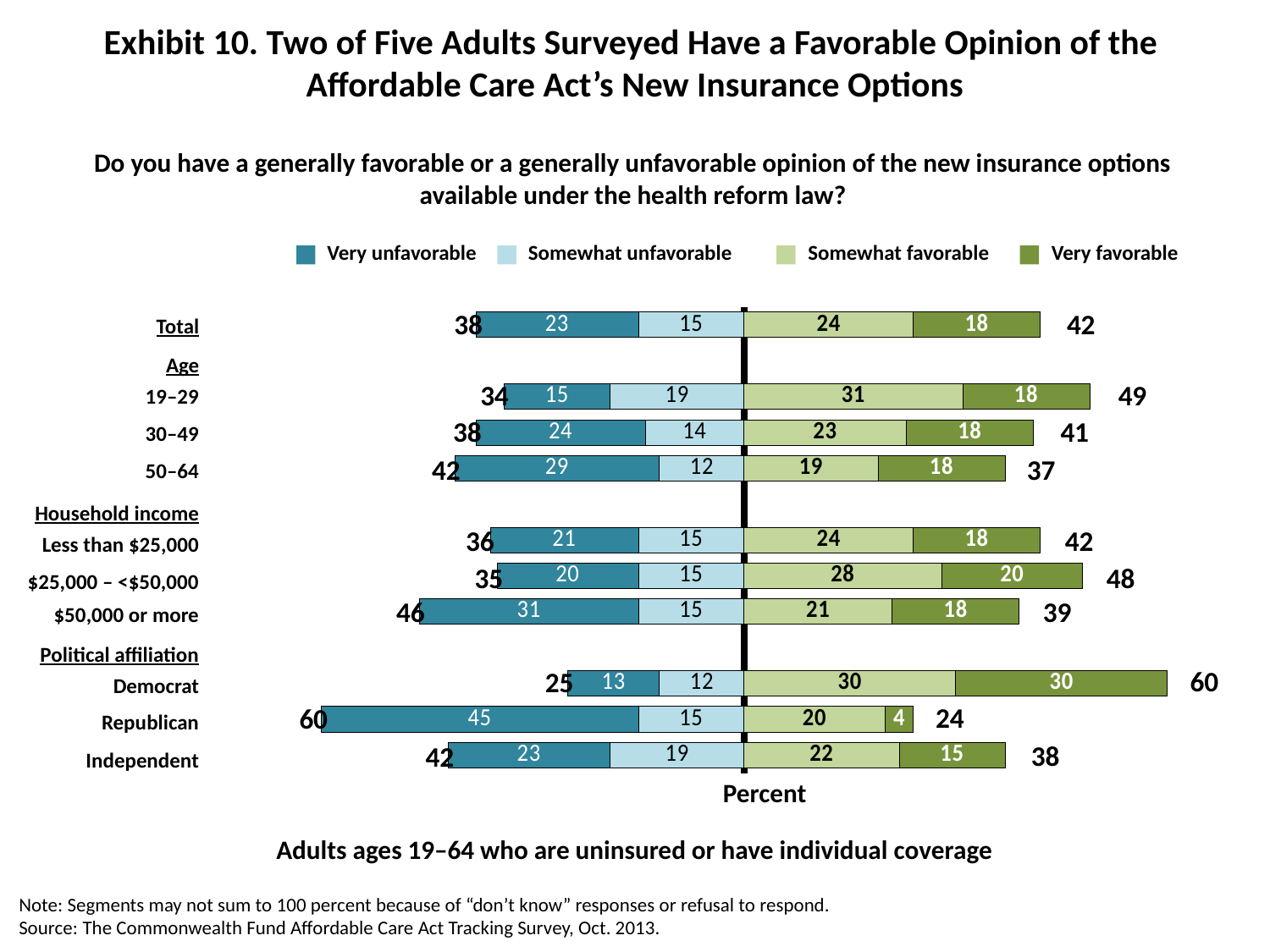
Which group has the highest 'Very favorable' value? Democrat How many series does the legend list? 4 What kind of chart is shown on the slide? Stacked bar chart Which group has the lowest 'Very favorable' value? Republican How many groups (bars) are plotted in the chart? 10 What is the combined favorable total (somewhat favorable plus very favorable) for Democrats? 60 What is the 'Somewhat favorable' value for adults ages 19–29? 31 What percentage of Republicans are very unfavorable toward the new insurance options? 45 Which is larger: the 'Somewhat favorable' value for $25,000 – <$50,000 or for $50,000 or more? $25,000 – <$50,000 What is the difference between the 'Very unfavorable' values for Republicans and Democrats? 32 Which legend entry is shown in the darkest green colour? Very favorable What is the combined unfavorable total (very unfavorable plus somewhat unfavorable) for adults ages 50–64? 42